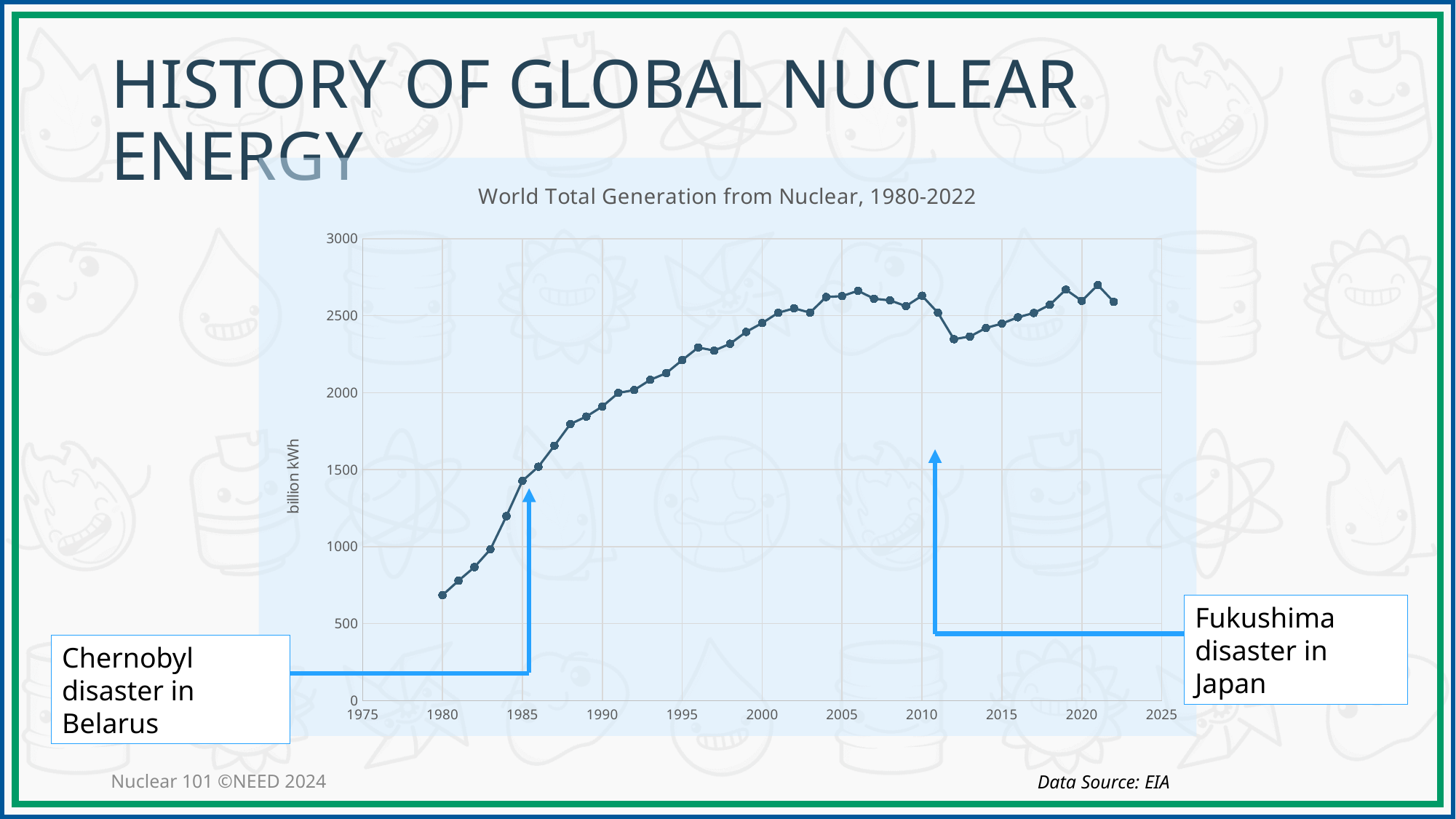
Is the value for 1985 greater or less than 1500? less Which year has the lowest value on the chart? 1980 Is the value for 2022 greater or less than 2500? greater What is the title of the chart? World Total Generation from Nuclear, 1980-2022 What unit is shown on the vertical axis of the chart? billion kWh Is the value for 2000 greater or less than 2000? greater What kind of chart is shown on the slide? line chart Do the values rise or fall from 1980 to 2005? rise Which year has the larger value, 2010 or 2012? 2010 Which year has the larger value, 1990 or 2000? 2000